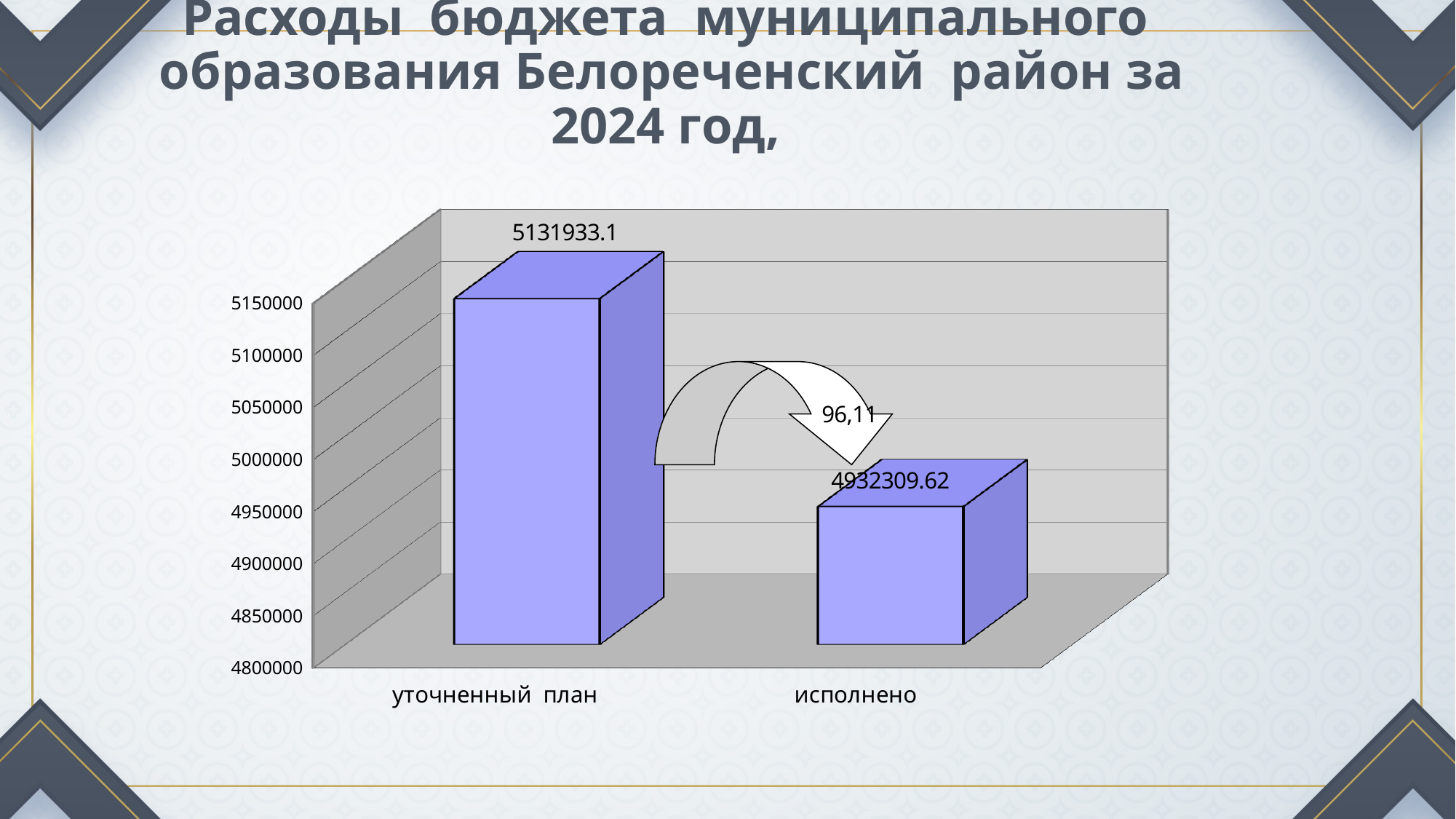
Is the value for "уточненный план" greater or less than 5100000? greater What is the value for "исполнено"? 4932309.62 What is the difference between the values for "уточненный план" and "исполнено"? 199623.48 Which is larger, the value for "уточненный план" or the value for "исполнено"? уточненный план Is the value for "исполнено" greater or less than 5000000? less Which category has the lowest value? исполнено What is the value for "уточненный план"? 5131933.1 What is the lowest value shown on the vertical axis? 4800000 How many categories are shown on the chart? 2 What number is printed next to the arrow between the two bars? 96,11 Which category has the highest value? уточненный план What kind of chart is shown on the slide? bar chart